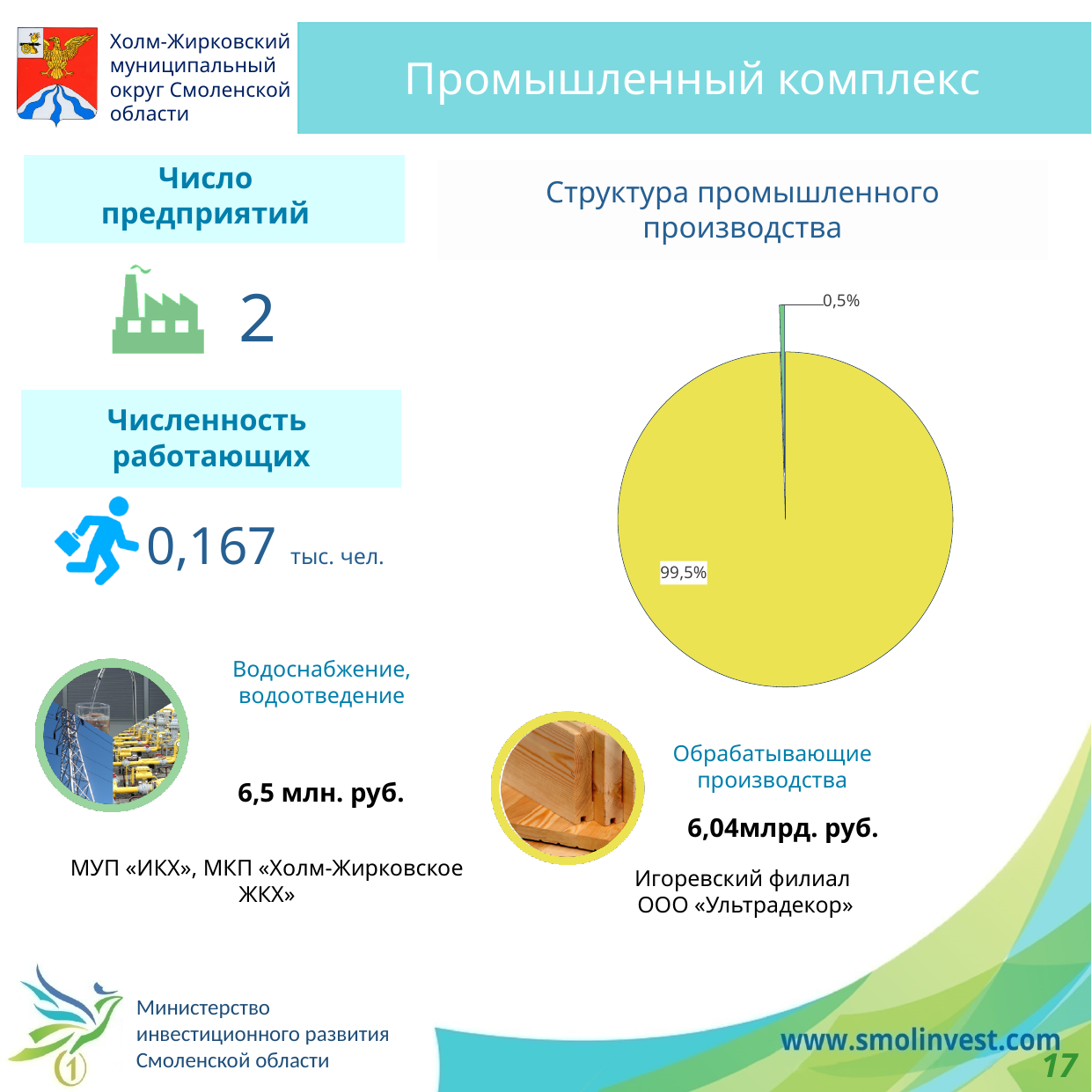
What colour is the slice labelled 99,5% in the pie chart? yellow What is the title of the pie chart on the slide? Структура промышленного производства How many slices does the pie chart have? 2 What share does the yellow slice of the pie chart represent? 99,5% What do the two slices of the pie chart add up to? 100% What is the difference in percentage points between the two slices of the pie chart? 99 What share does the small green slice of the pie chart represent? 0,5% What is the share of the smallest slice in the pie chart? 0,5% Is the share of the yellow slice in the pie chart greater or less than 50%? greater Which slice of the pie chart is larger, the yellow one or the green one? the yellow one What is the share of the largest slice in the pie chart? 99,5% What kind of chart is shown under the title "Структура промышленного производства"? pie chart